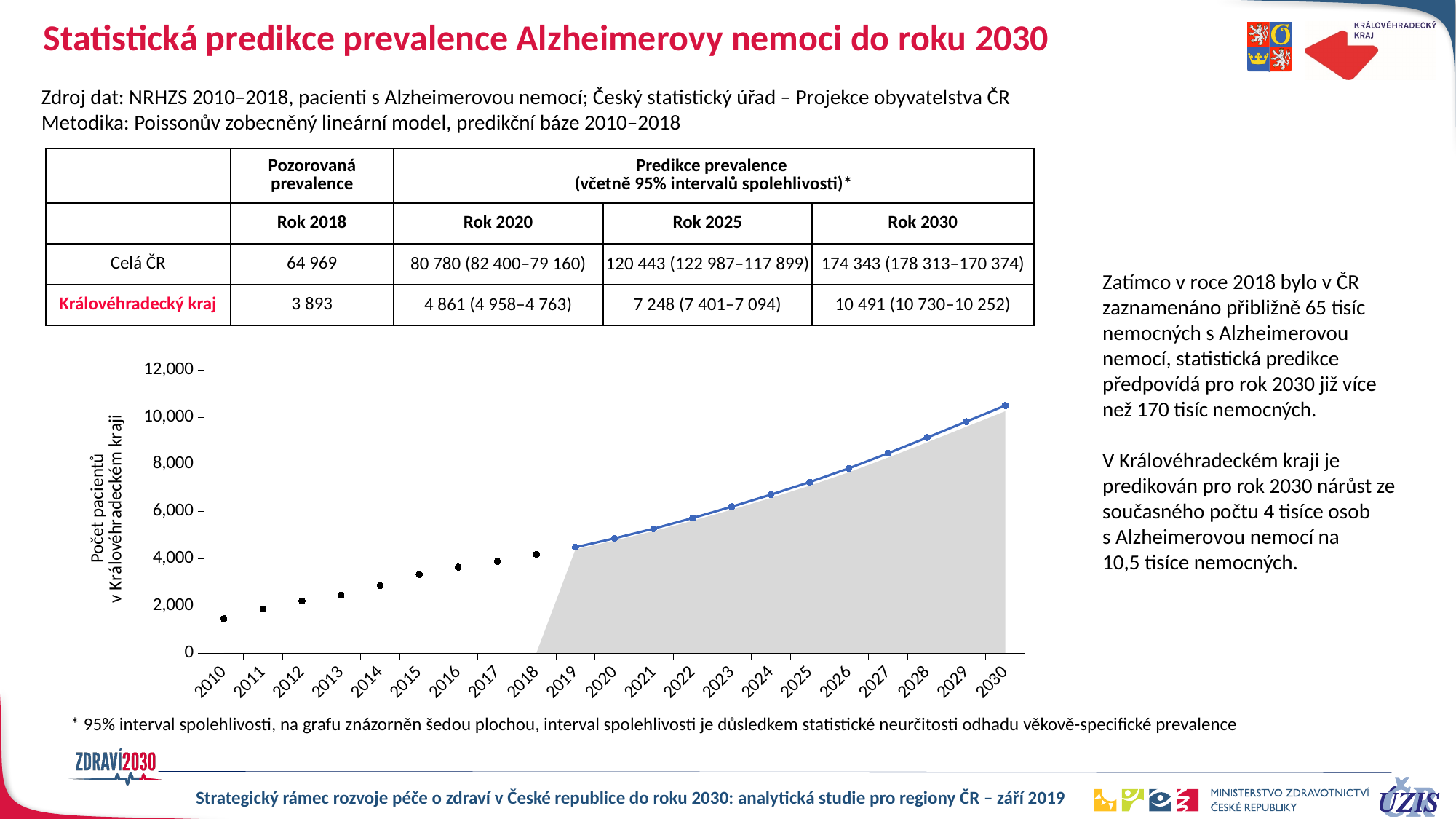
Do the values in the chart rise or fall from 2010 to 2030? rise Which year has the lowest value in the chart? 2010 Which year has the highest value in the chart? 2030 What does the grey area in the chart represent, according to the footnote? 95% interval spolehlivosti Is the value for 2030 larger than the value for 2020? Yes Is the value for 2025 greater or less than 6,000? greater How many years are shown on the x axis of the chart? 21 Is the value for 2010 greater or less than 2,000? less Is the value for 2030 greater or less than 10,000? greater What is the label of the y axis of the chart? Počet pacientů v Královéhradeckém kraji What kind of chart is shown on the slide? line chart